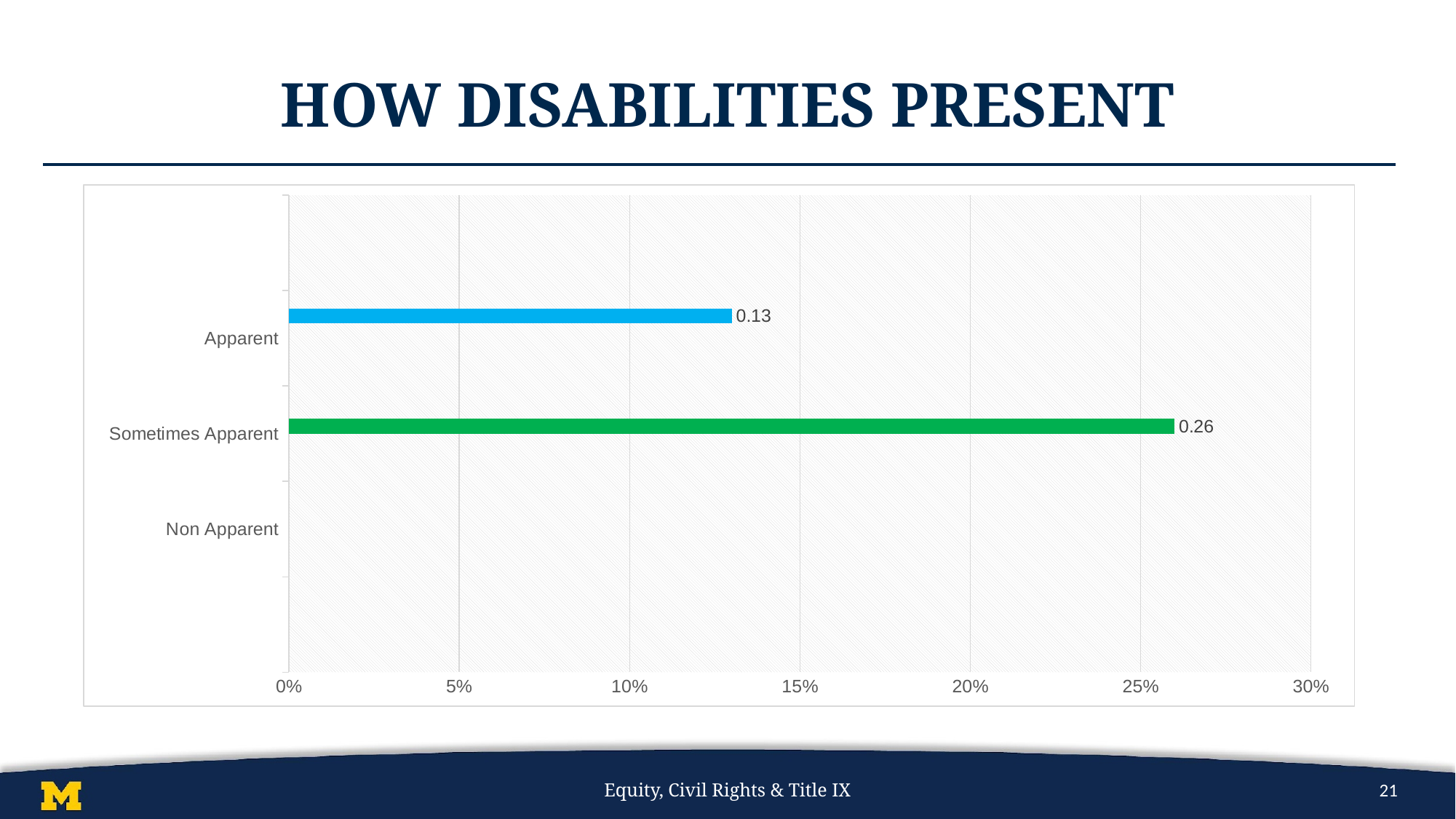
What is the title of the slide? HOW DISABILITIES PRESENT What is the value shown for Apparent? 0.13 Is the value for Apparent greater or less than 15%? less What is the value shown for Sometimes Apparent? 0.26 Is the value for Sometimes Apparent greater or less than 20%? greater Which is larger, the value for Apparent or the value for Sometimes Apparent? Sometimes Apparent Is the value for Apparent greater or less than 10%? greater How many categories are listed on the vertical axis? 3 What is the difference between the values for Sometimes Apparent and Apparent? 0.13 What colour is the bar for Sometimes Apparent? green What kind of chart is shown on the slide? bar chart